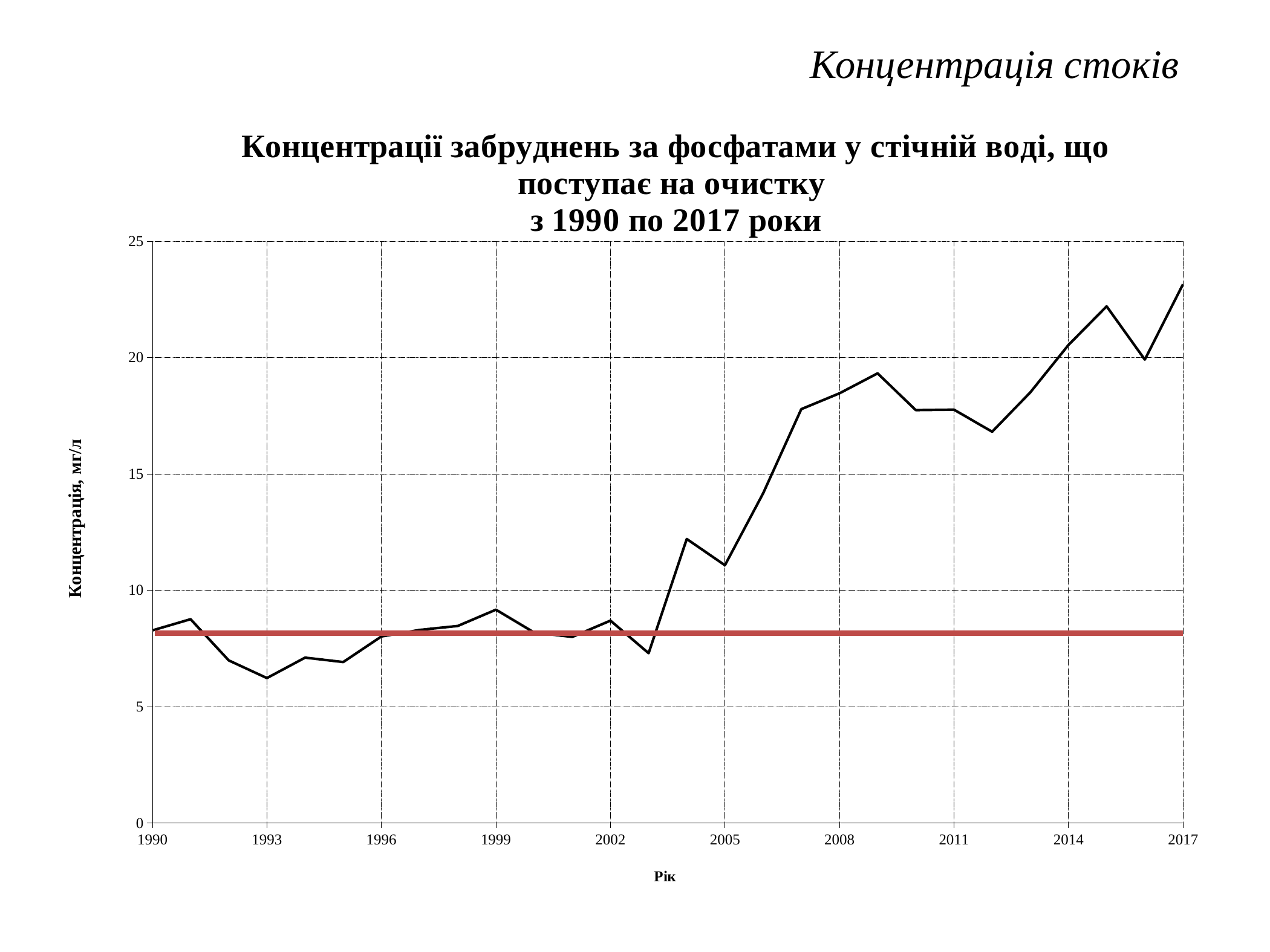
Is the value for 2012 greater or less than 15? greater Is the value for 2017 greater or less than 20? greater Which year has the larger value, 2004 or 2005? 2004 Is the value for 2005 greater or less than 10? greater What is the label of the y axis? Концентрація, мг/л Which year has the highest phosphate concentration? 2017 Which year has the larger value, 2009 or 2012? 2009 Overall, do the phosphate concentration values rise or fall from 1990 to 2017? rise What is the label of the x axis? Рік Which year has the lowest phosphate concentration? 1993 What kind of chart is shown on the slide? line chart